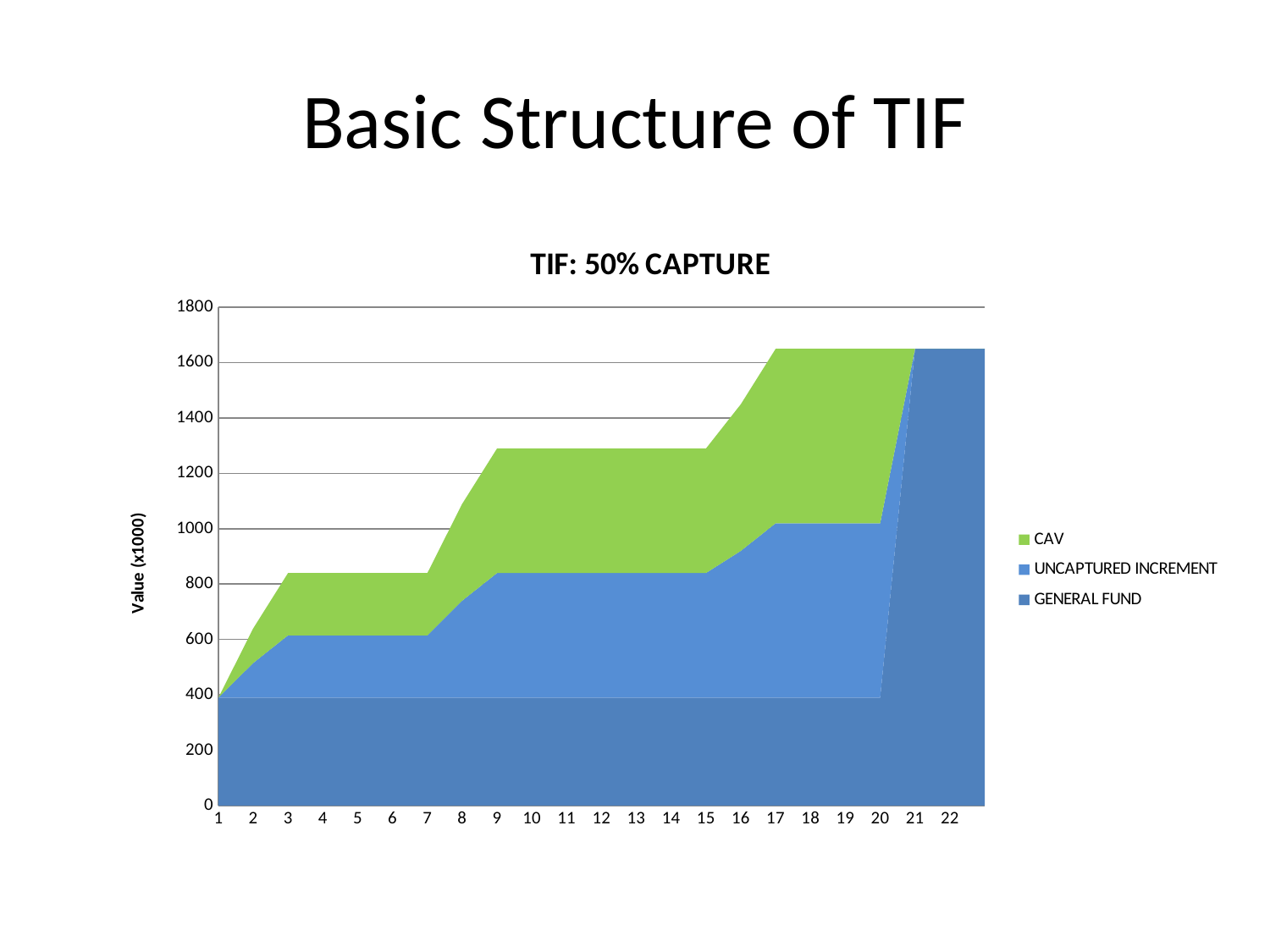
At which x value is the total stacked value lowest? 1 Is the total stacked value at x = 17 greater or less than 1400? greater Is the total stacked value larger at x = 17 or at x = 9? x = 17 Is the total stacked value at x = 3 greater or less than 600? greater What kind of chart is shown on the slide? area chart Do the total stacked values generally rise or fall from x = 1 to x = 22? rise Which series is shown in green in the legend? CAV Is the GENERAL FUND value at x = 10 greater or less than 600? less How many series does the legend list? 3 What is the title of the chart? TIF: 50% CAPTURE How many points are labelled along the x axis? 22